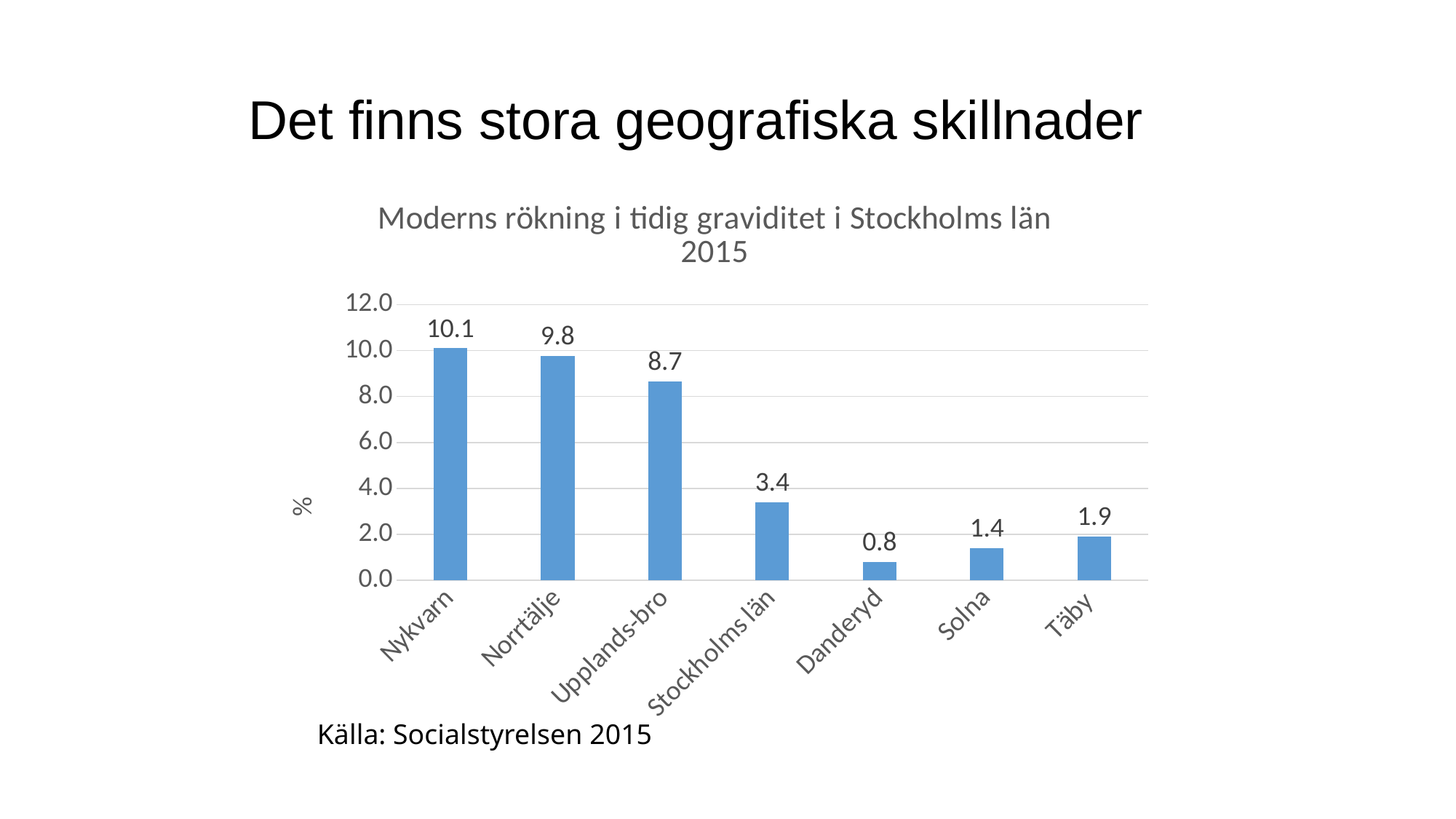
What is the title of the chart? Moderns rökning i tidig graviditet i Stockholms län 2015 What is the value for Danderyd? 0.8 What is the value for Stockholms län? 3.4 Is the value for Upplands-bro greater or less than 8.0? greater How many categories are shown on the x axis? 7 What is the value for Nykvarn? 10.1 What is the difference between the values for Norrtälje and Upplands-bro? 1.1 Which category has the highest value? Nykvarn What kind of chart is shown on the slide? bar chart What is the difference between the values for Nykvarn and Täby? 8.2 Which category has the lowest value? Danderyd Which is larger, the value for Solna or the value for Täby? Täby